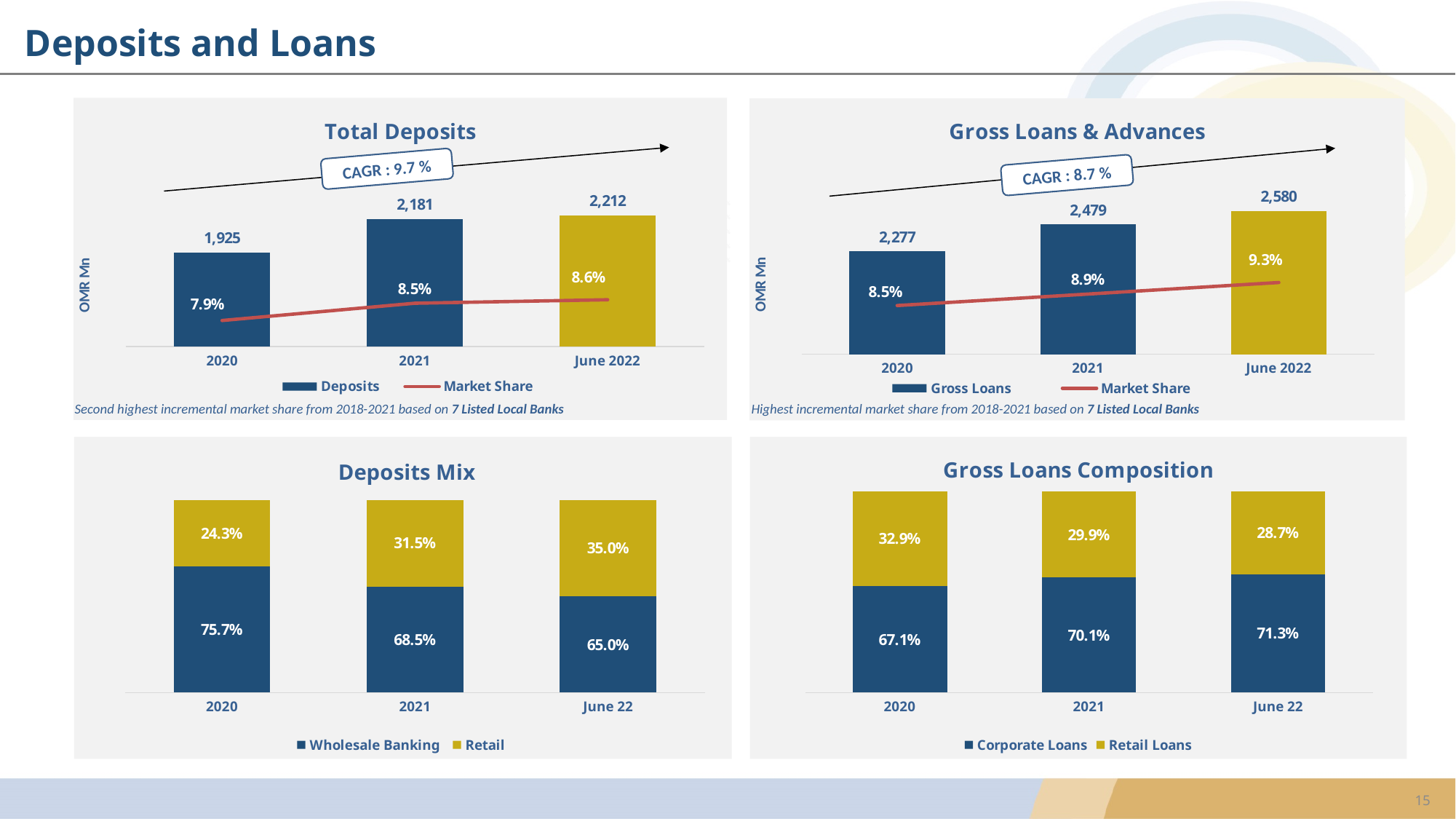
In the Deposits Mix chart, does the Wholesale Banking share rise or fall from 2020 to June 22? fall In the Total Deposits chart, what is the value of deposits for 2021? 2,181 In the Gross Loans Composition chart, which is larger in 2020: Corporate Loans or Retail Loans? Corporate Loans In the Total Deposits chart, what is the market share for June 2022? 8.6% In the Gross Loans & Advances chart, which period has the lowest gross loans value? 2020 How many series does the legend of the Deposits Mix chart list? 2 In the Gross Loans Composition chart, what is the Corporate Loans share for June 22? 71.3% In the Deposits Mix chart, what is the Retail share for 2021? 31.5% In the Gross Loans & Advances chart, what is the difference in gross loans between 2021 and 2020? 202 In the Total Deposits chart, what is the difference in deposits between June 2022 and 2020? 287 What CAGR is shown on the Gross Loans & Advances chart? 8.7 % In the Gross Loans & Advances chart, what is the value of gross loans for June 2022? 2,580